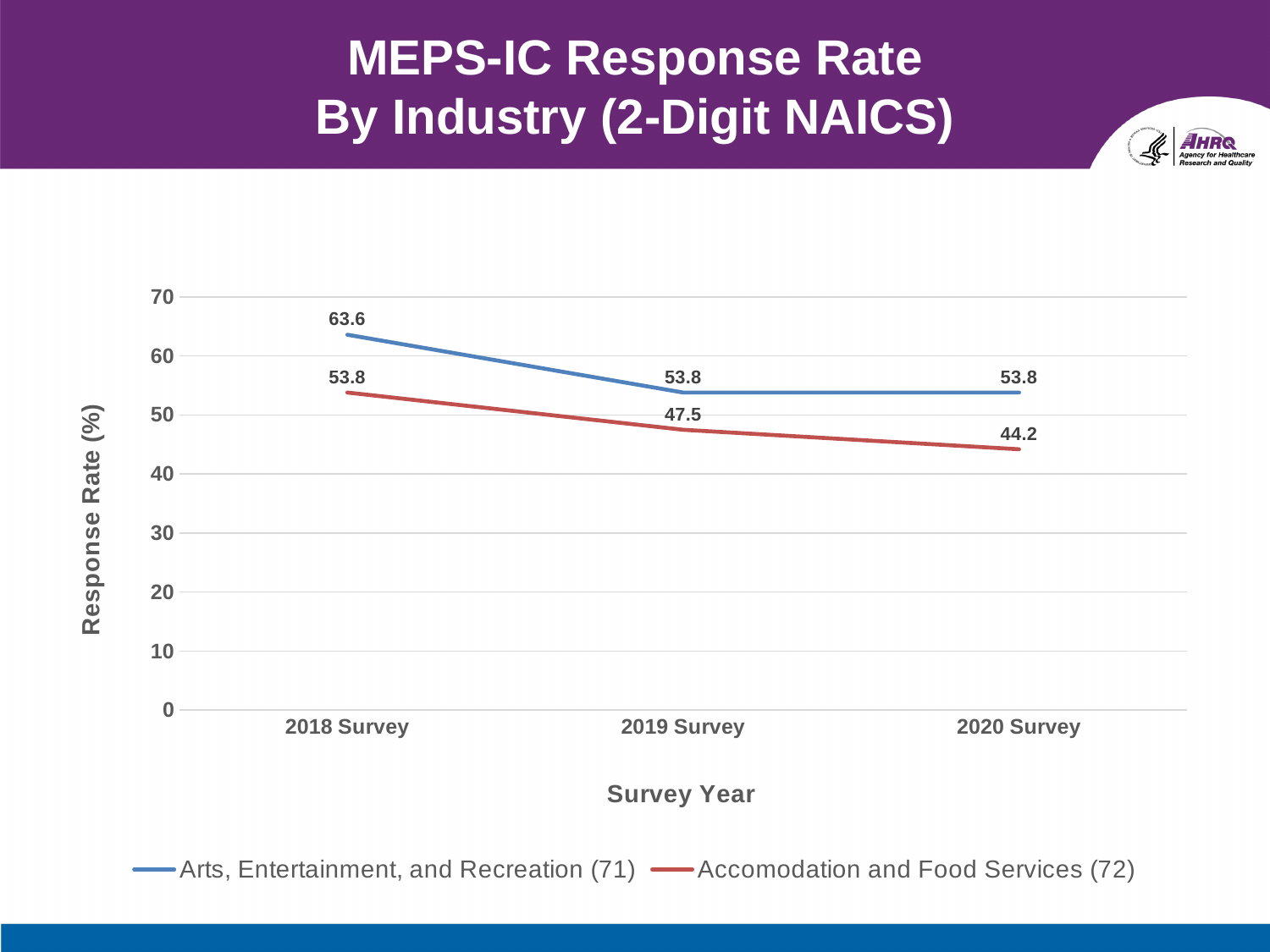
What is the response rate for Accomodation and Food Services (72) in the 2019 Survey? 47.5 What is the response rate for Arts, Entertainment, and Recreation (71) in the 2018 Survey? 63.6 What is the difference between the two industries' response rates in the 2020 Survey? 9.6 What is the response rate for Accomodation and Food Services (72) in the 2020 Survey? 44.2 In which survey year is the response rate for Accomodation and Food Services (72) lowest? 2020 Survey Does the response rate for Accomodation and Food Services (72) rise or fall from the 2018 Survey to the 2020 Survey? Fall How many survey years are shown on the x axis? 3 What kind of chart is shown on the slide? Line chart What is the difference between the 2018 and 2019 response rates for Arts, Entertainment, and Recreation (71)? 9.8 How many series does the legend list? 2 Which industry has the higher response rate in the 2019 Survey? Arts, Entertainment, and Recreation (71) In which survey year is the response rate for Arts, Entertainment, and Recreation (71) highest? 2018 Survey